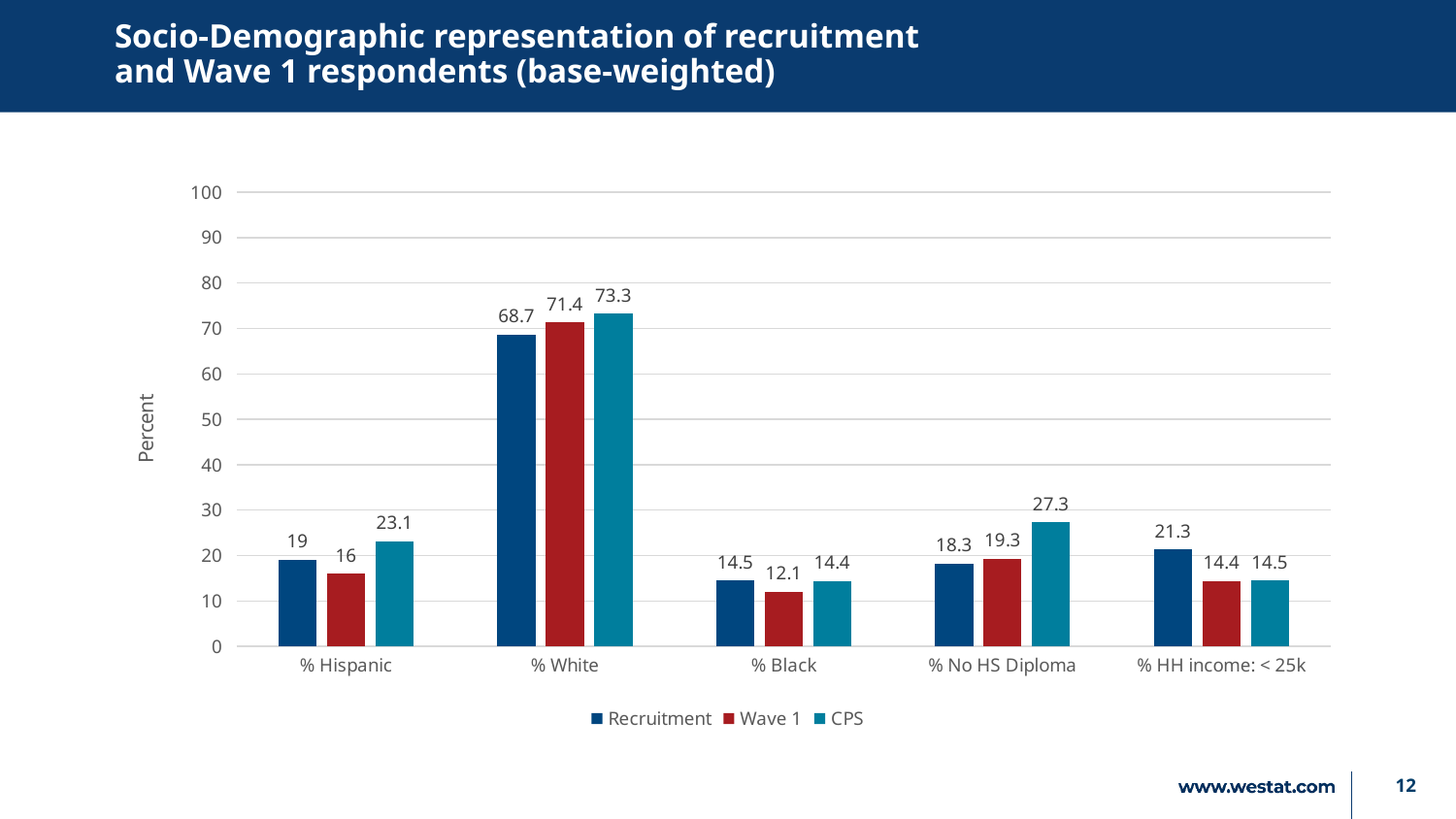
What is the Wave 1 value for % Black? 12.1 Which category has the highest CPS value? % White What is the difference between the CPS and Recruitment values for % White? 4.6 How many categories are shown on the x axis? 5 Which category has the lowest Wave 1 value? % Black What kind of chart is shown on the slide? Bar chart Which is larger for % HH income: < 25k, the Recruitment value or the Wave 1 value? Recruitment What is the Recruitment value for % Hispanic? 19 What is the CPS value for % No HS Diploma? 27.3 How many series does the legend list? 3 What is the label of the y axis? Percent Is the Wave 1 value for % White greater or less than 70? greater